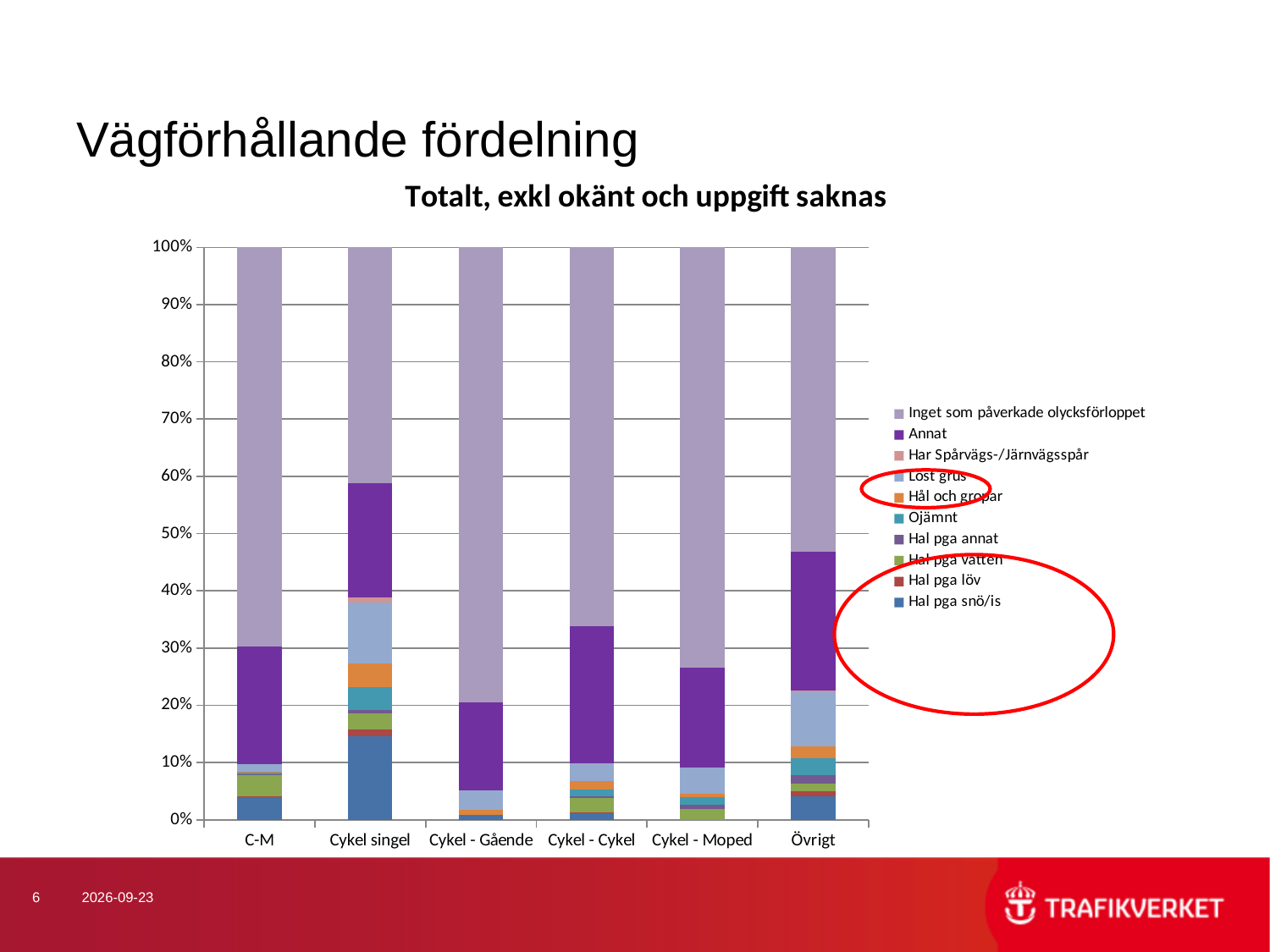
Which category has the largest 'Inget som påverkade olycksförloppet' share? Cykel - Gående Is the 'Hal pga snö/is' share for Cykel singel greater or less than 10%? greater Is the 'Inget som påverkade olycksförloppet' share for Cykel - Gående greater or less than 70%? greater Which series is listed first in the chart's legend? Inget som påverkade olycksförloppet Which has the larger 'Hal pga snö/is' share, C-M or Cykel singel? Cykel singel Is the 'Inget som påverkade olycksförloppet' share for Cykel singel greater or less than 50%? less How many categories are shown on the x axis of the chart? 6 What kind of chart is shown on the slide? Stacked bar chart How many series does the chart's legend list? 10 What is the title of the chart? Totalt, exkl okänt och uppgift saknas Which category has the smallest 'Inget som påverkade olycksförloppet' share? Cykel singel